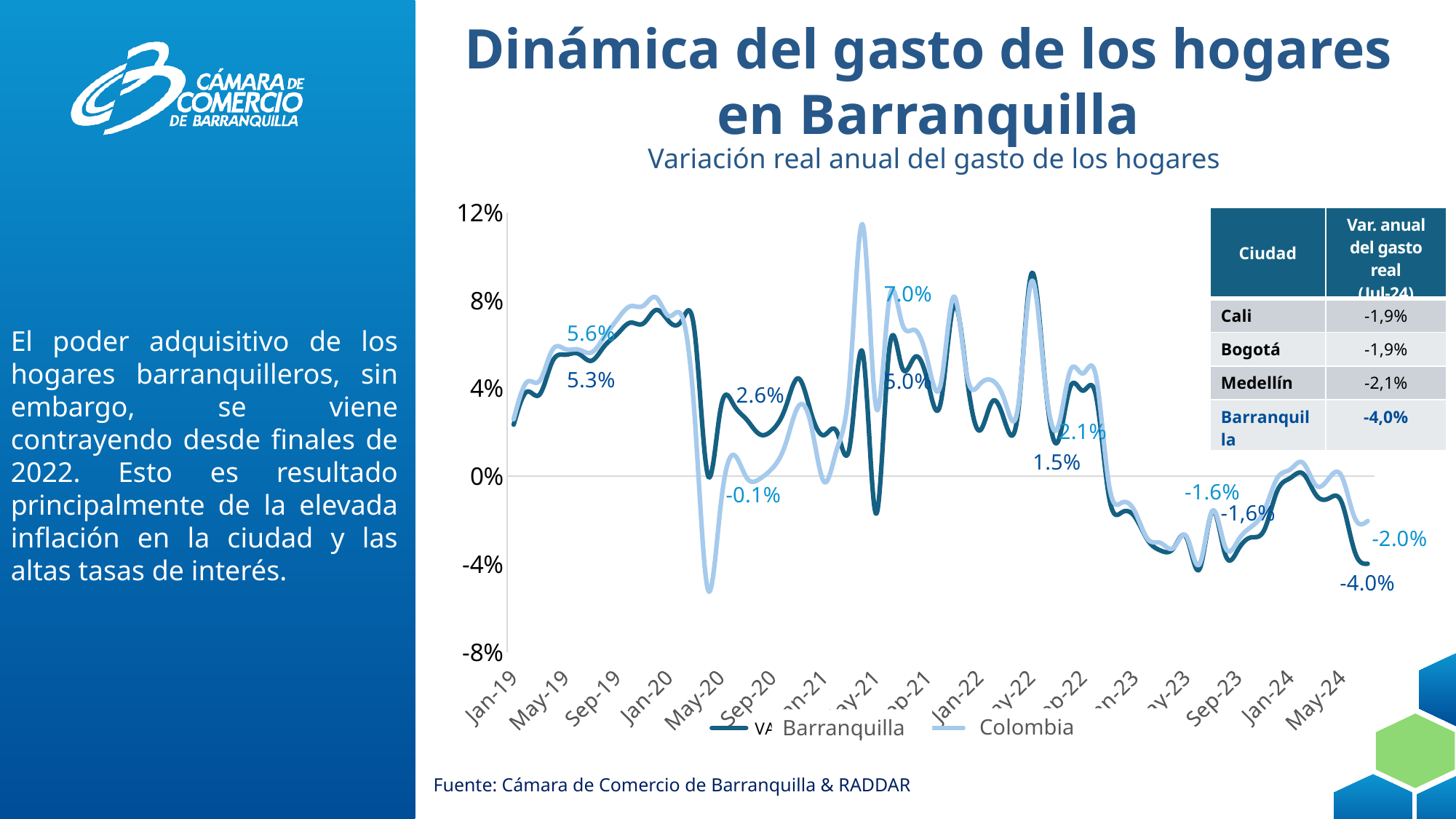
What is the difference between the final labelled values of Colombia (-2.0%) and Barranquilla (-4.0%)? 2.0 percentage points Is the peak of the Colombia line around May-21 greater or less than 8%? greater What is the highest labelled value shown on the Colombia line, near May-21? 7.0% What kind of chart is shown on the slide? line chart In the table, what value is shown for Cali? -1,9% At the right end of the chart, which series has the higher final labelled value, Barranquilla or Colombia? Colombia What is the highest value shown on the vertical axis of the chart? 12% What is the last labelled value for the Colombia series at the right end of the chart? -2.0% Is the lowest point of the Colombia line around May-20 greater or less than -4%? less In the table, which city has the lowest annual variation of real spending (Jul-24)? Barranquilla In the table, what is the annual variation of real spending (Jul-24) for Medellín? -2,1% What is the last labelled value for the Barranquilla series at the right end of the chart? -4.0%